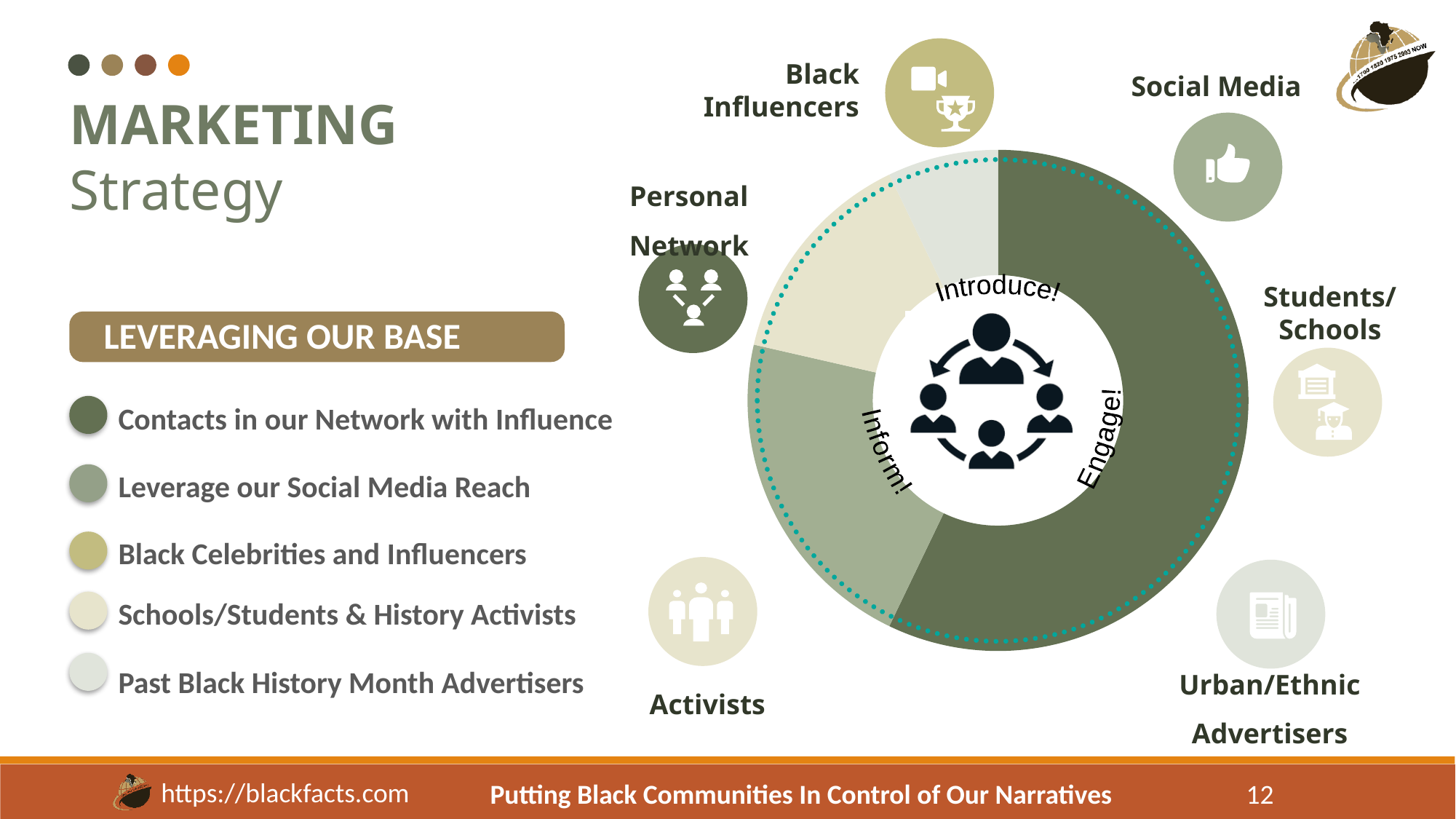
Which slice is larger in the donut chart: the dark green slice (Contacts in our Network with Influence) or the very light grey slice (Past Black History Month Advertisers)? Contacts in our Network with Influence Which slice is larger in the donut chart: the medium green slice (Leverage our Social Media Reach) or the very light grey slice (Past Black History Month Advertisers)? Leverage our Social Media Reach How many categories are listed in the legend on the left of the slide? 5 What kind of chart is shown on the slide? Pie chart (donut) What three words are printed around the centre of the donut chart? Introduce!, Engage!, Inform! What colour is the largest slice of the donut chart? Dark green Which legend category corresponds to the largest slice of the donut chart? Contacts in our Network with Influence